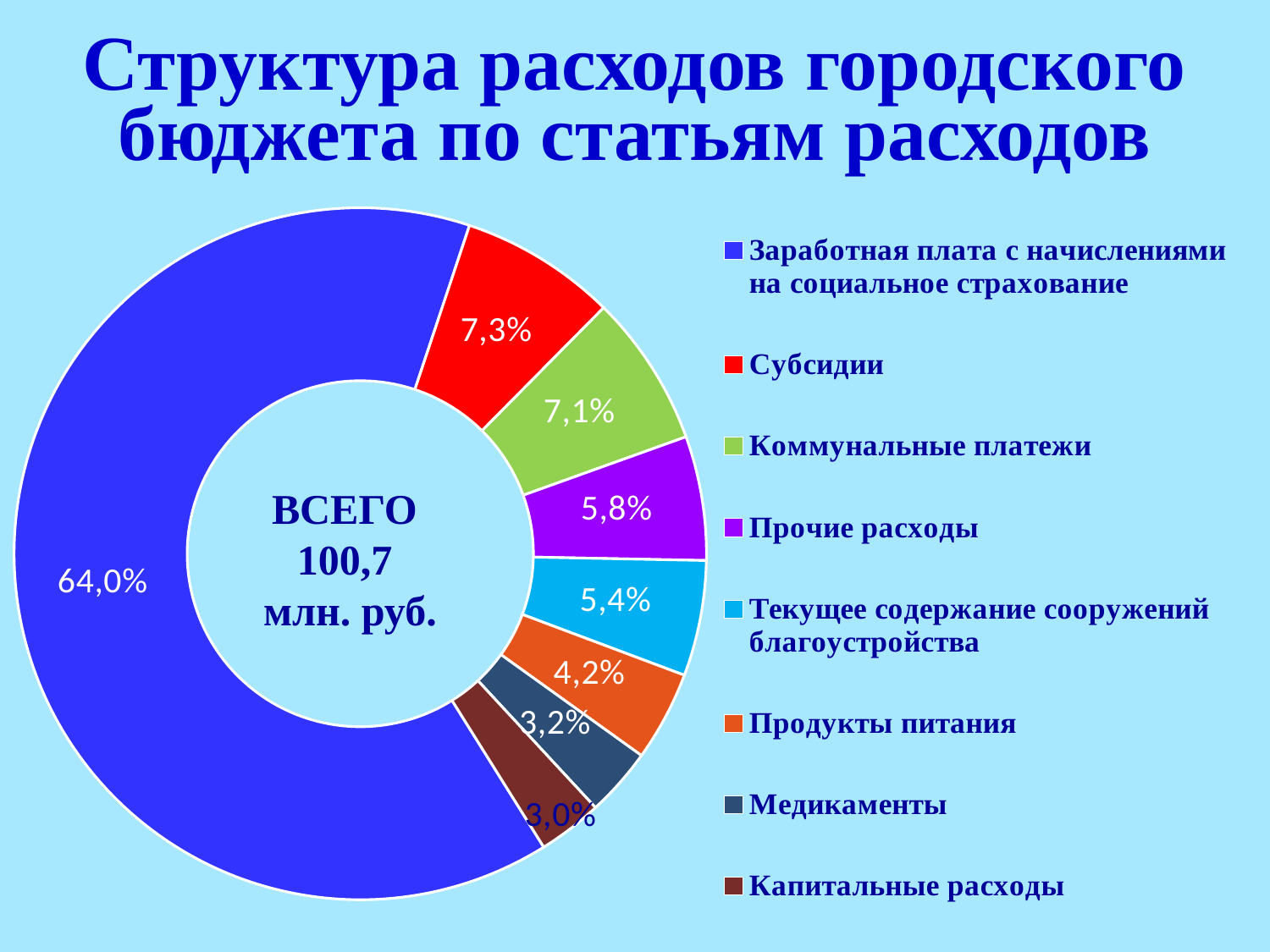
Which expenditure item has the largest share of the budget? Заработная плата с начислениями на социальное страхование How many expenditure items are shown in the chart? 8 What percentage is shown for «Медикаменты»? 3,2% What percentage is shown for «Коммунальные платежи»? 7,1% What percentage is shown for «Субсидии»? 7,3% What type of chart is shown on the slide? Doughnut (pie) chart What colour represents «Прочие расходы» in the chart? Purple What is the difference in percentage points between «Прочие расходы» and «Текущее содержание сооружений благоустройства»? 0,4 Which expenditure item has the smallest share of the budget? Капитальные расходы What total amount is shown in the centre of the chart? ВСЕГО 100,7 млн. руб. Which has a larger share: «Продукты питания» or «Медикаменты»? Продукты питания What share of the city budget expenditures goes to «Заработная плата с начислениями на социальное страхование»? 64,0%